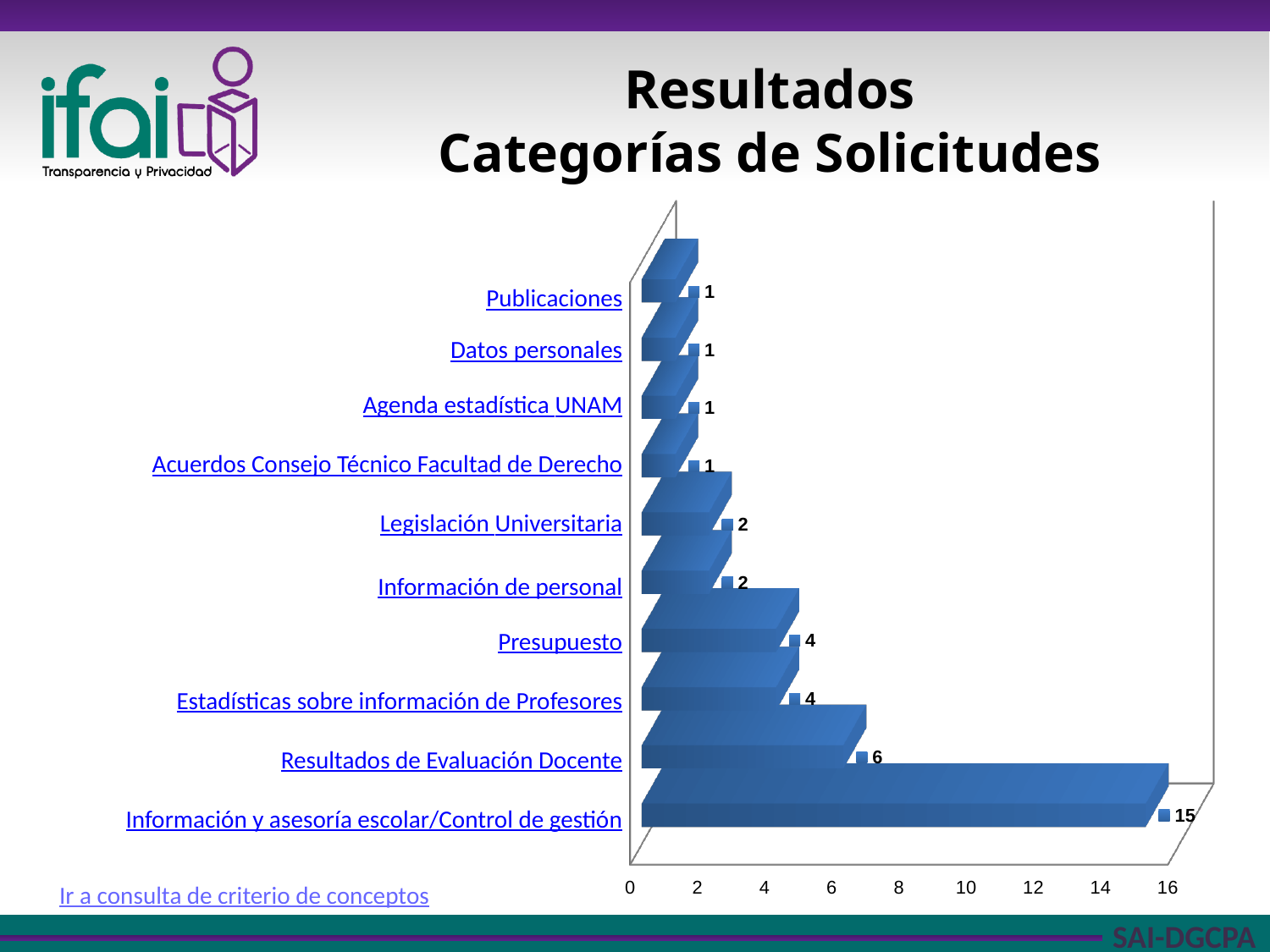
Is the value for Información y asesoría escolar/Control de gestión greater or less than 14? greater Which is larger, the value for Presupuesto or the value for Información de personal? Presupuesto What is the difference between the values for Información y asesoría escolar/Control de gestión and Resultados de Evaluación Docente? 9 Which category has the highest value? Información y asesoría escolar/Control de gestión What is the value for Resultados de Evaluación Docente? 6 How many categories are shown in the chart? 10 What is the value for Presupuesto? 4 What kind of chart is shown on the slide? bar chart What is the title of the slide? Resultados Categorías de Solicitudes How many categories have a value of 1? 4 What is the value for Legislación Universitaria? 2 What is the value for Información y asesoría escolar/Control de gestión? 15